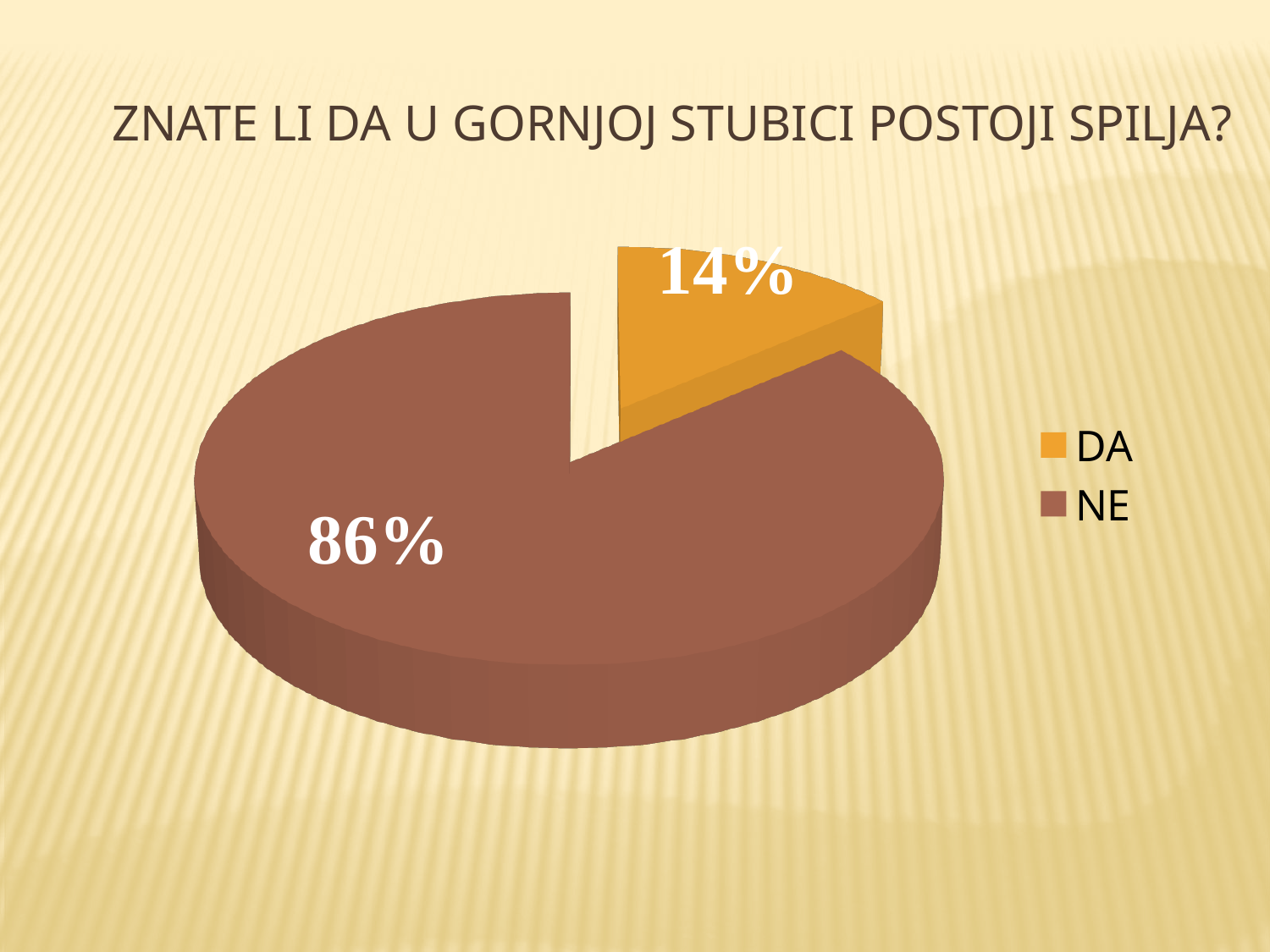
How many slices does the pie chart have? 2 Which category has the largest share of the pie? NE What share of the pie does the DA slice represent? 14% What kind of chart is shown on the slide? pie chart What percentage of the pie is labelled NE? 86% What percentage of the pie is labelled DA? 14% Which category has the smallest share of the pie? DA What is the difference in percentage points between the NE and DA slices? 72 What colour is the NE slice of the pie? brown How many entries does the legend list? 2 What is the title of the chart? ZNATE LI DA U GORNJOJ STUBICI POSTOJI SPILJA? Which slice is larger, DA or NE? NE